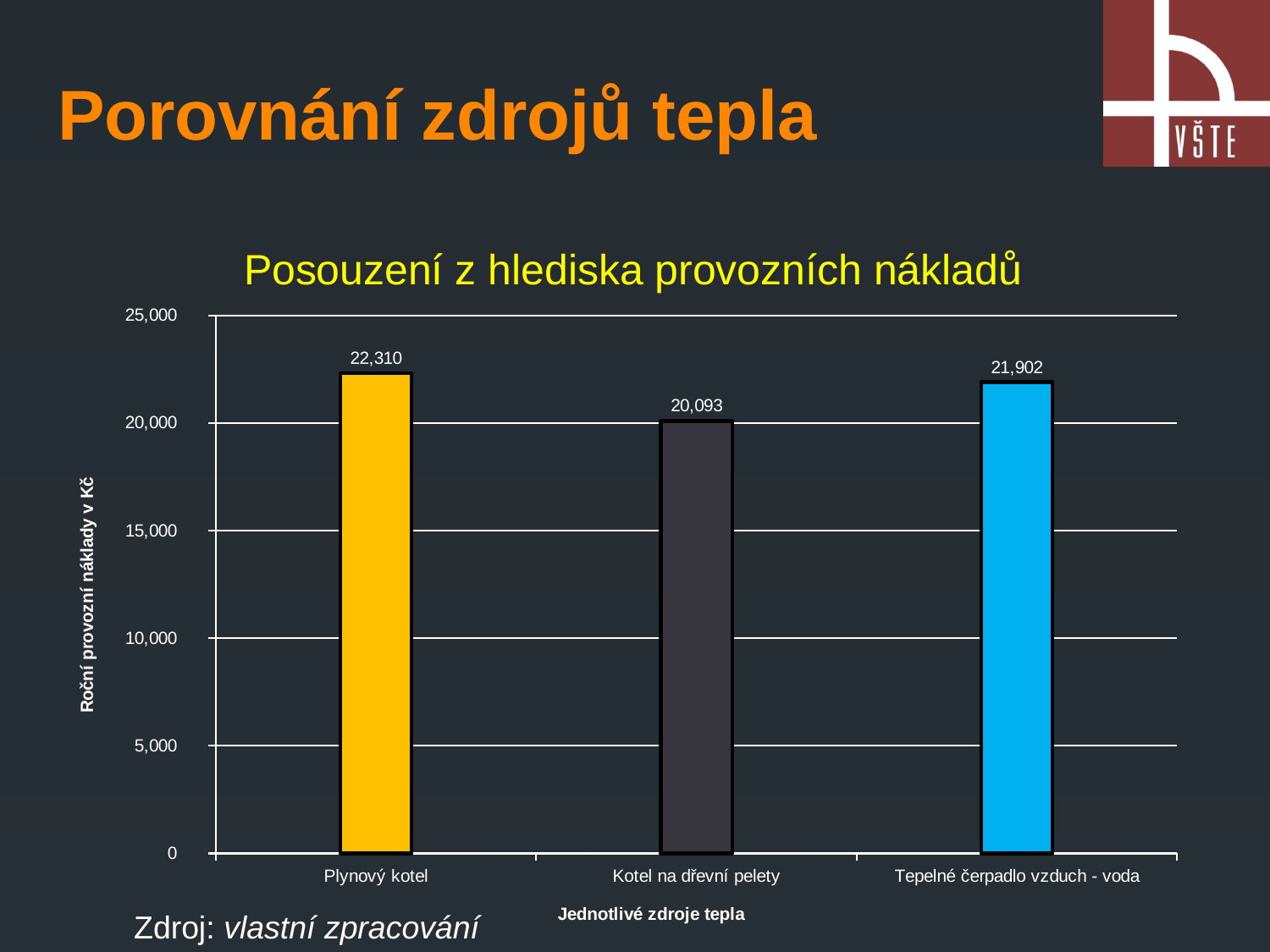
Which has a higher annual operating cost, Tepelné čerpadlo vzduch - voda or Kotel na dřevní pelety? Tepelné čerpadlo vzduch - voda How many heat sources are shown in the chart? 3 What is the annual operating cost for Tepelné čerpadlo vzduch - voda? 21,902 What is the difference in annual operating cost between Plynový kotel and Kotel na dřevní pelety? 2,217 What is the annual operating cost for Plynový kotel? 22,310 Which heat source has the highest annual operating cost? Plynový kotel Which heat source has the lowest annual operating cost? Kotel na dřevní pelety What type of chart is shown on the slide? bar chart What is the annual operating cost for Kotel na dřevní pelety? 20,093 What is the difference in annual operating cost between Plynový kotel and Tepelné čerpadlo vzduch - voda? 408 Is the value for Kotel na dřevní pelety greater or less than 25,000? less What is the title of the chart? Posouzení z hlediska provozních nákladů